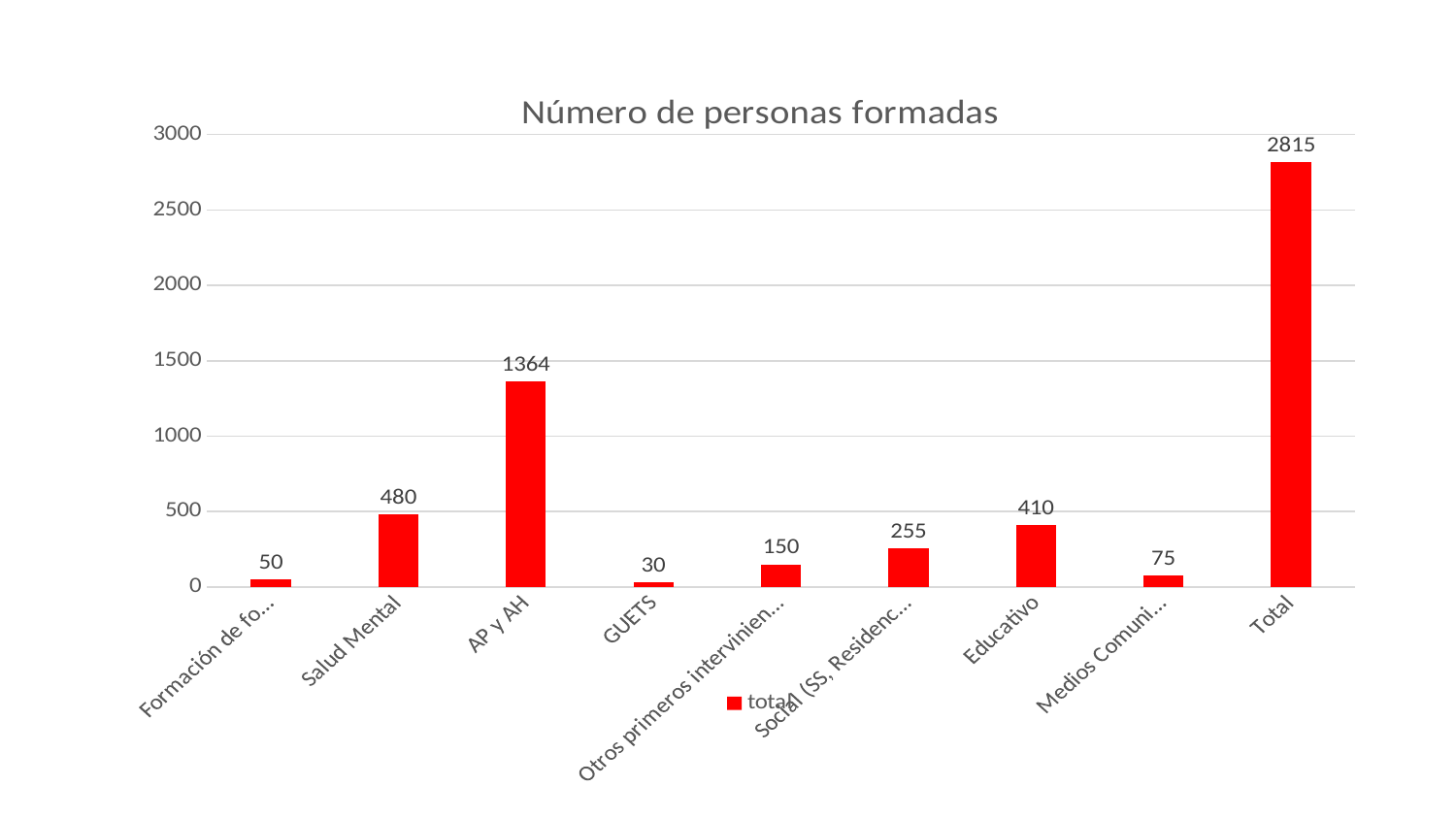
What is the difference between the values for Salud Mental and Educativo? 70 Which category has the lowest value? GUETS What is the value for Salud Mental? 480 Which is larger, the value for Salud Mental or the value for Educativo? Salud Mental Excluding the Total bar, which category has the highest value? AP y AH Is the value for AP y AH greater or less than 1000? greater What is the value for the Total bar? 2815 What is the value for AP y AH? 1364 What is the value for Educativo? 410 What is the title of the chart? Número de personas formadas What is the value for GUETS? 30 How many bars are shown in the chart? 9